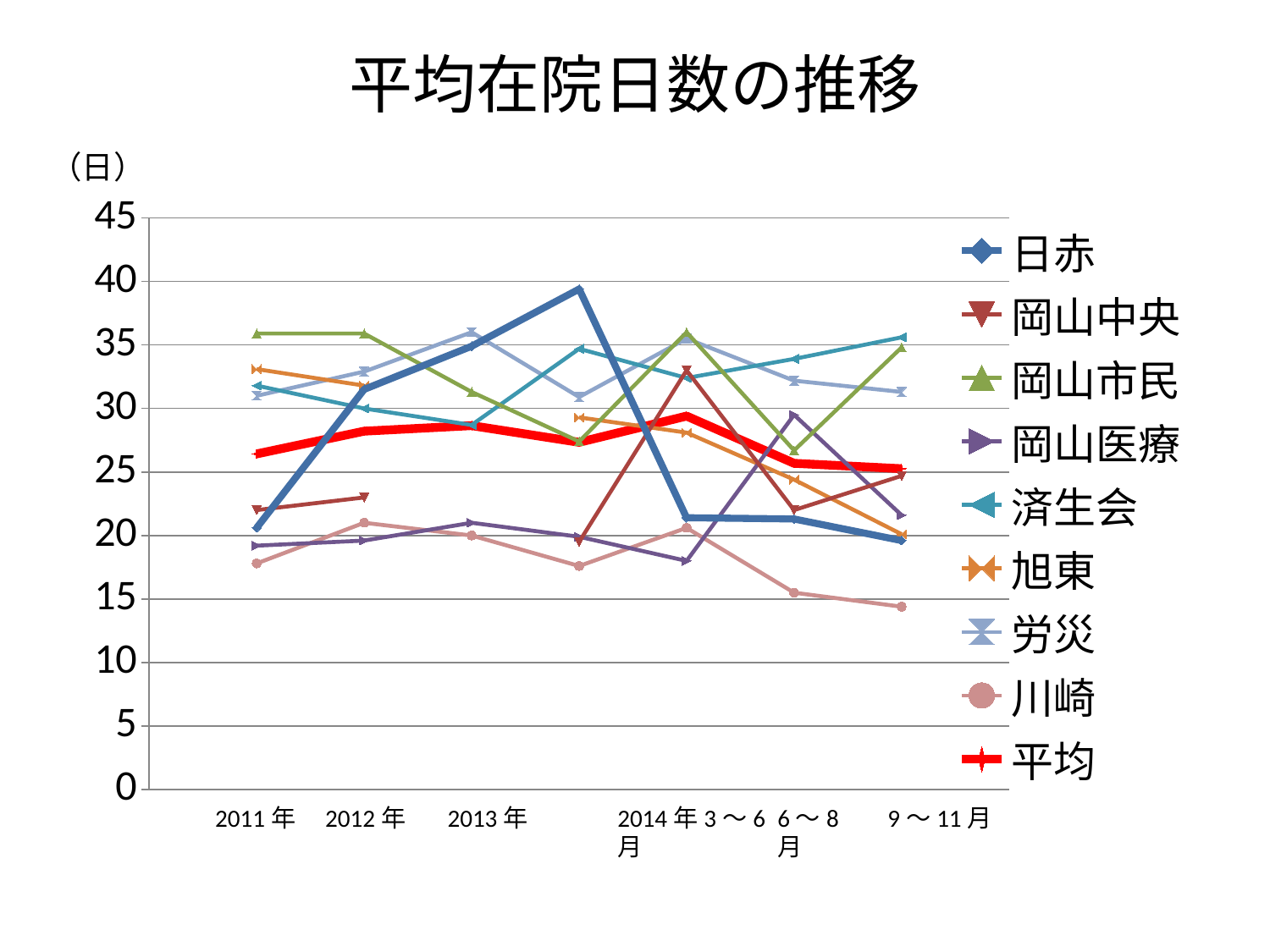
Does the value for 川崎 rise or fall from 2014年3～6月 to 9～11月? fall Is the value for 川崎 in 9～11月 greater or less than 20? less In 2013年, which is larger, the value for 日赤 or the value for 川崎? 日赤 Is the value for 日赤 in 2011年 greater or less than 25? less What unit is shown above the vertical axis? （日） Which series has the lowest value in 9～11月? 川崎 Is the value for 平均 in 2011年 greater or less than 30? less What kind of chart is shown on the slide? line chart What is the title of the chart? 平均在院日数の推移 Which series has the highest value in 2011年? 岡山市民 How many series does the legend list? 9